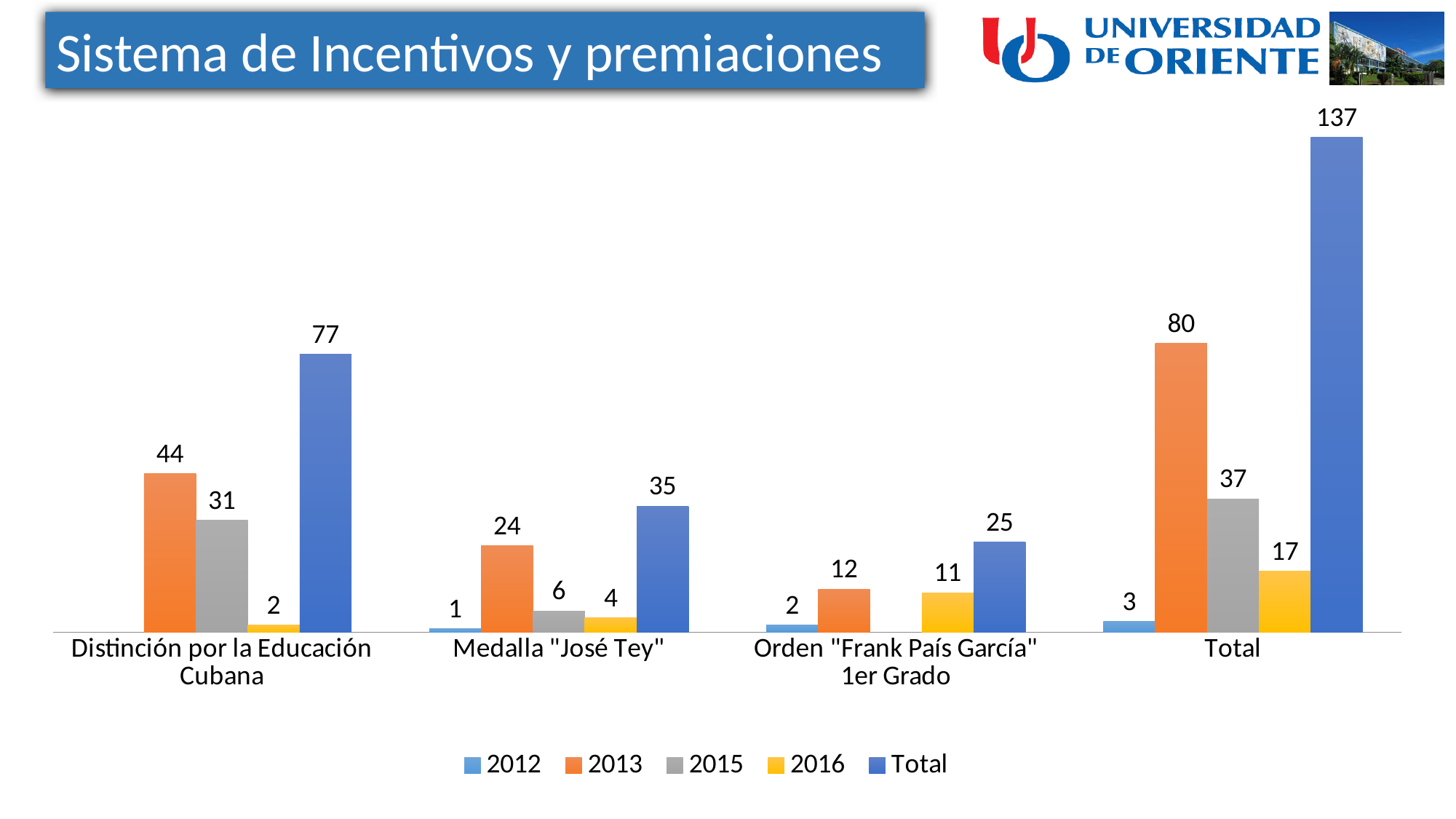
What kind of chart is shown on the slide? bar chart How many categories are shown on the x axis? 4 What is the 2016 value for Orden "Frank País García" 1er Grado? 11 What is the 2015 value in the Total category? 37 What is the Total value for Medalla "José Tey"? 35 Among the three award categories (excluding Total), which has the lowest Total value? Orden "Frank País García" 1er Grado How many series does the legend list? 5 What is the 2013 value for Distinción por la Educación Cubana? 44 Which category has the highest Total bar? Total What is the title of the slide containing the chart? Sistema de Incentivos y premiaciones Which is larger for Medalla "José Tey": the 2015 value or the 2016 value? 2015 What is the difference between the 2013 value and the 2015 value for Distinción por la Educación Cubana? 13